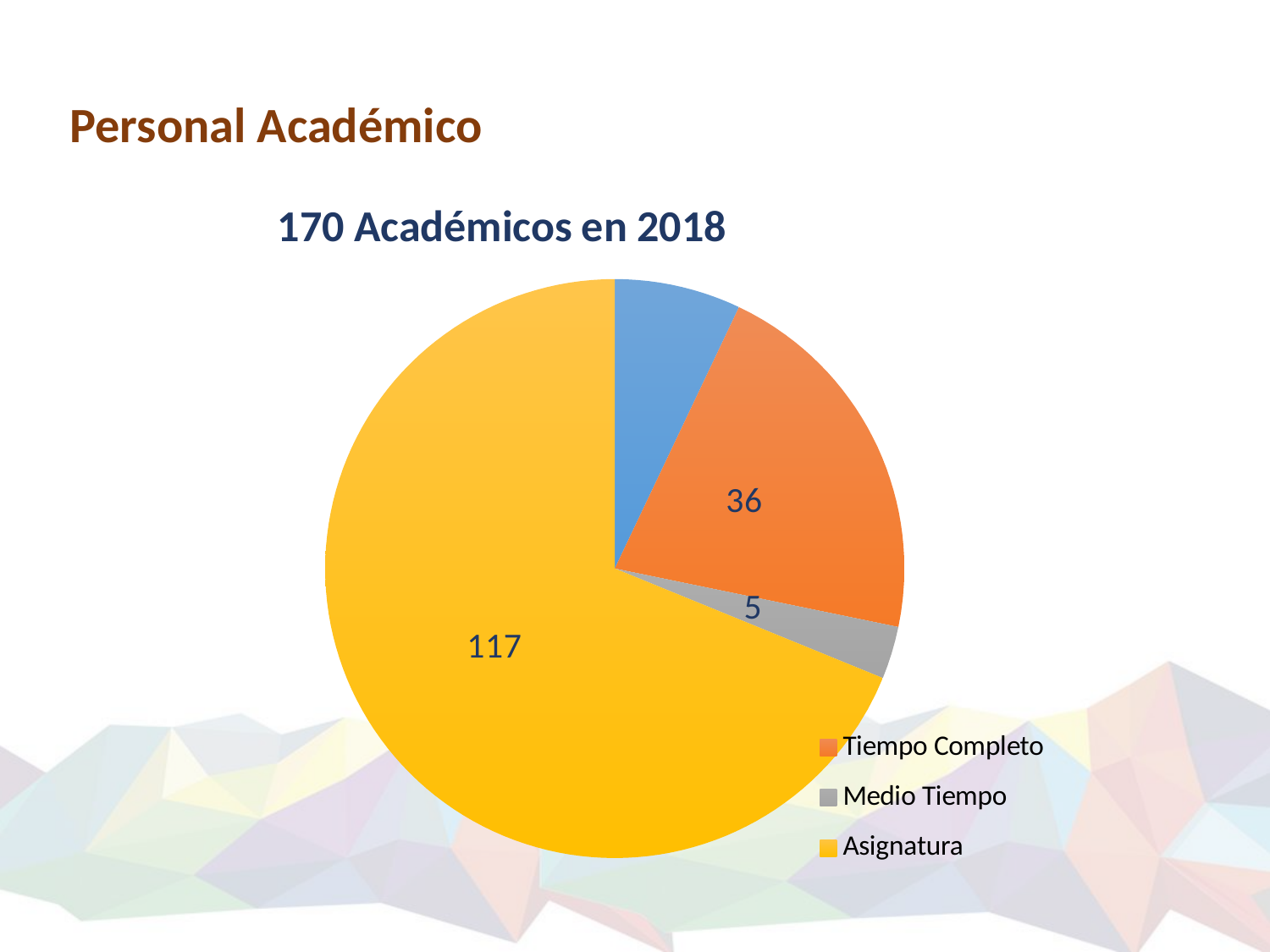
What is the value for Tiempo Completo? 36 What colour is the Asignatura slice in the pie chart? yellow Which category has the largest slice of the pie? Asignatura What is the difference between the values for Tiempo Completo and Medio Tiempo? 31 What is the value for Medio Tiempo? 5 What is the value for Asignatura? 117 How many entries does the chart legend list? 3 What is the difference between the values for Asignatura and Tiempo Completo? 81 Which labelled category has the smallest slice of the pie? Medio Tiempo Which is larger, the value for Tiempo Completo or the value for Medio Tiempo? Tiempo Completo What is the title of the chart? 170 Académicos en 2018 What kind of chart is shown on the slide? pie chart